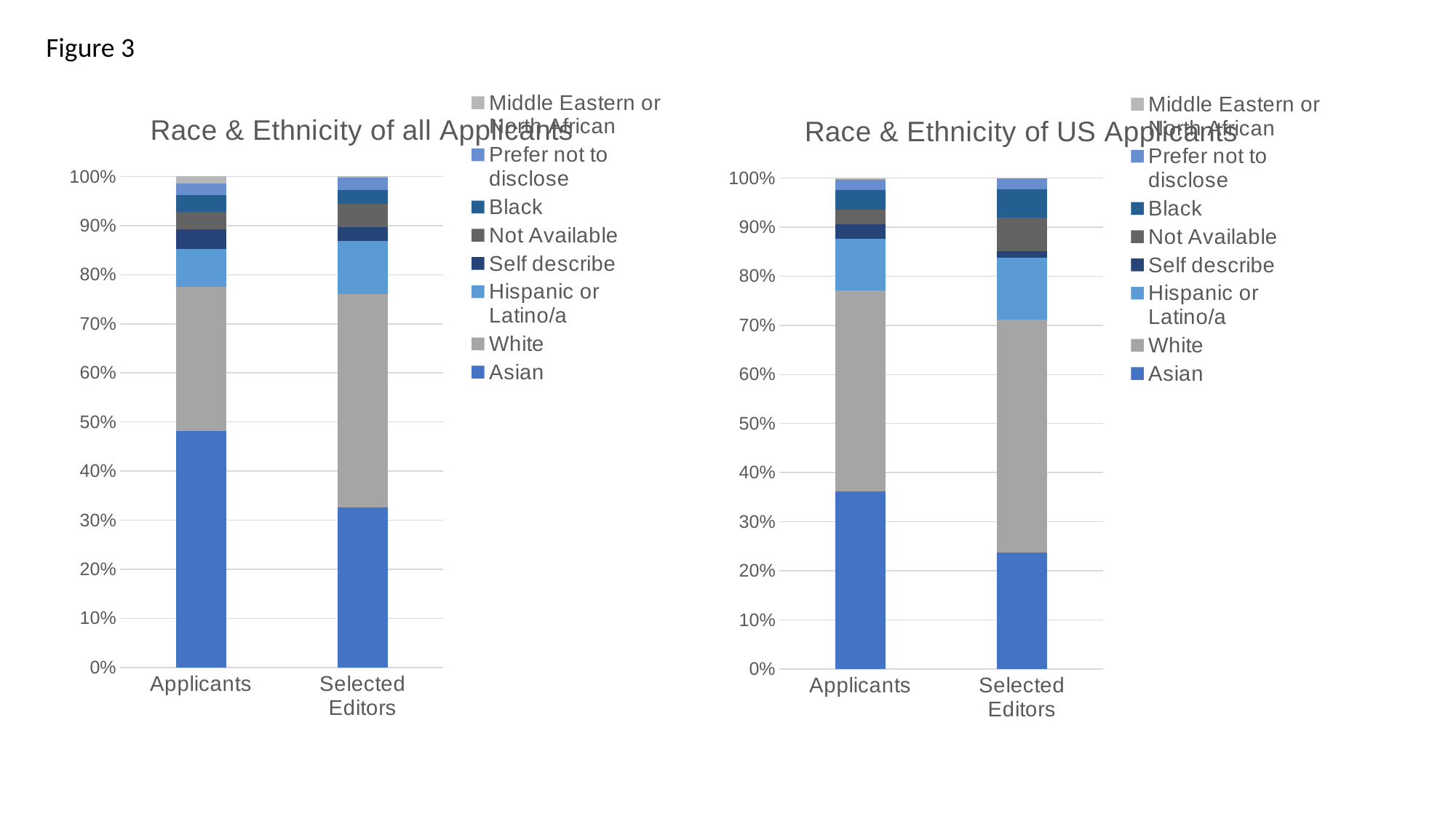
In the 'Race & Ethnicity of US Applicants' chart, which group has the larger Asian share: Applicants or Selected Editors? Applicants In the 'Race & Ethnicity of all Applicants' chart, is the Asian share for Selected Editors greater or less than 40%? less In the 'Race & Ethnicity of all Applicants' chart, which group has the larger Asian share: Applicants or Selected Editors? Applicants In the 'Race & Ethnicity of US Applicants' chart, is the Asian share for Applicants greater or less than 40%? less What is the title of the chart on the right side of the slide? Race & Ethnicity of US Applicants In the 'Race & Ethnicity of all Applicants' chart, is the Asian share for Applicants greater or less than 40%? greater Which series is shown at the bottom of each stacked bar in the 'Race & Ethnicity of all Applicants' chart? Asian What kind of chart is the 'Race & Ethnicity of all Applicants' chart? Stacked bar chart In the 'Race & Ethnicity of all Applicants' chart, which group has the larger White share: Applicants or Selected Editors? Selected Editors How many categories are shown on the x axis of the 'Race & Ethnicity of US Applicants' chart? 2 How many series does the legend of the 'Race & Ethnicity of all Applicants' chart list? 8